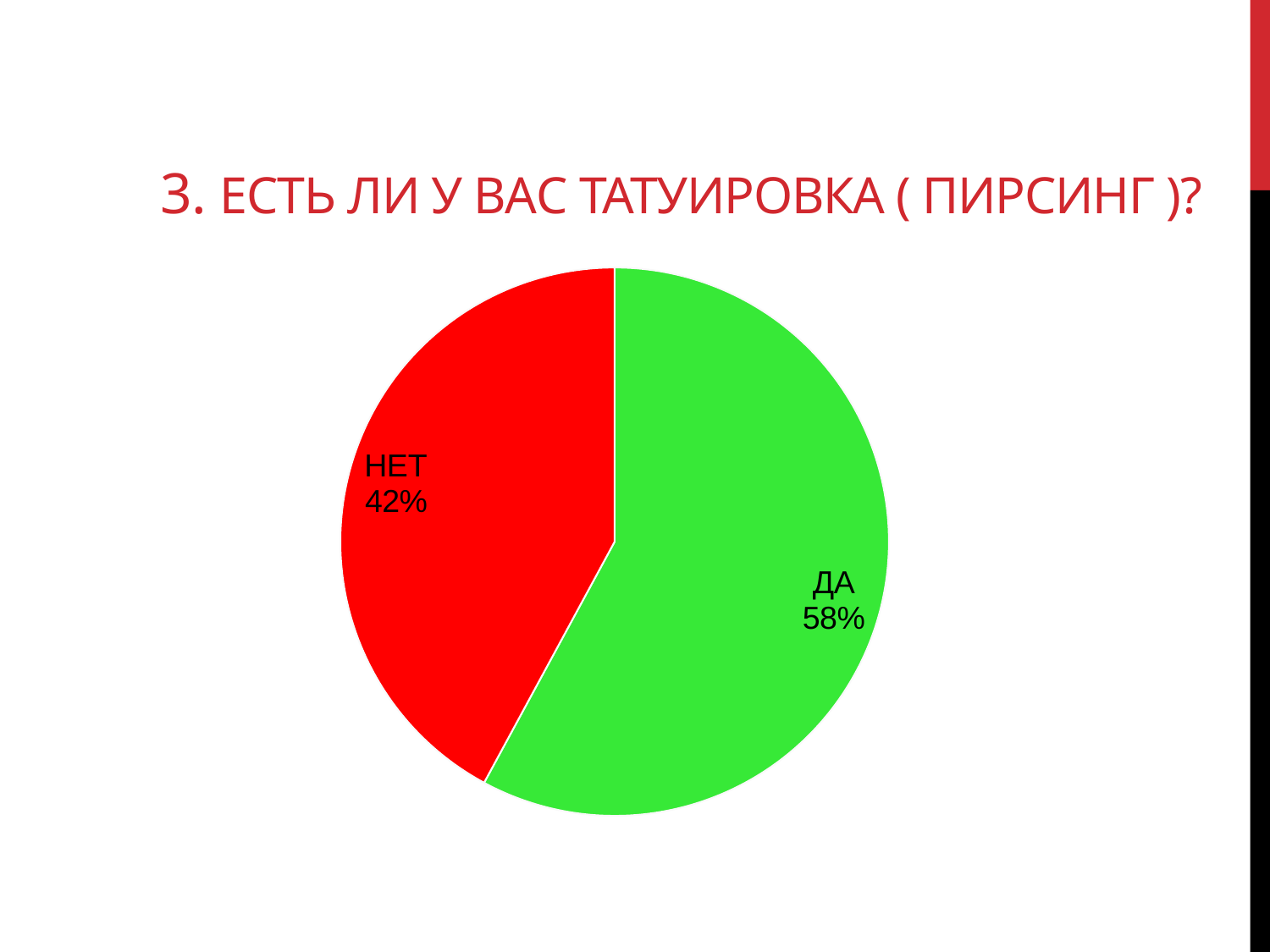
What kind of chart is shown on the slide? pie chart What share of the pie does the ДА slice take? 58% What percentage of the pie is labelled ДА? 58% What percentage of the pie is labelled НЕТ? 42% Which is larger, the ДА slice or the НЕТ slice? ДА What is the title of the slide above the chart? 3. ЕСТЬ ЛИ У ВАС ТАТУИРОВКА ( ПИРСИНГ )? What colour is the НЕТ slice? red Which slice is the smallest? НЕТ How many slices does the pie chart have? 2 Which slice is the largest? ДА What is the difference in percentage points between the ДА and НЕТ slices? 16